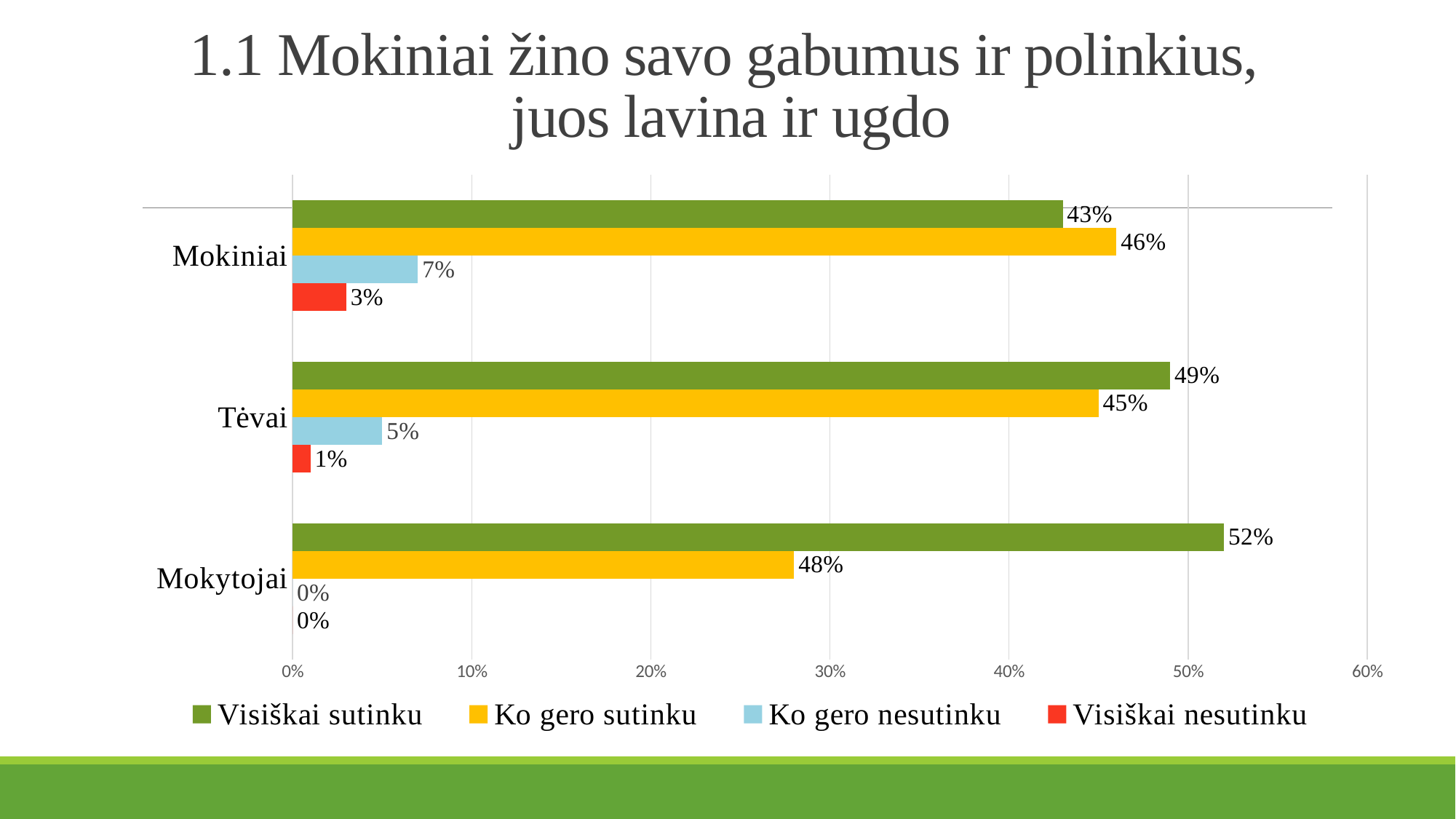
How many series does the legend list? 4 Which is larger for Tėvai: Visiškai sutinku or Ko gero sutinku? Visiškai sutinku What is the value for Visiškai sutinku for Mokiniai? 43% What is the value for Ko gero sutinku for Tėvai? 45% What kind of chart is shown on the slide? bar chart Which category has the lowest value for Ko gero nesutinku? Mokytojai Is the value for Ko gero sutinku for Mokiniai greater or less than 40%? greater What is the value for Visiškai nesutinku for Mokiniai? 3% Which category has the highest value for Visiškai sutinku? Mokytojai What is the difference between the Visiškai sutinku values for Mokytojai and Mokiniai? 9% What is the value for Ko gero nesutinku for Mokytojai? 0% How many categories are shown on the y axis? 3